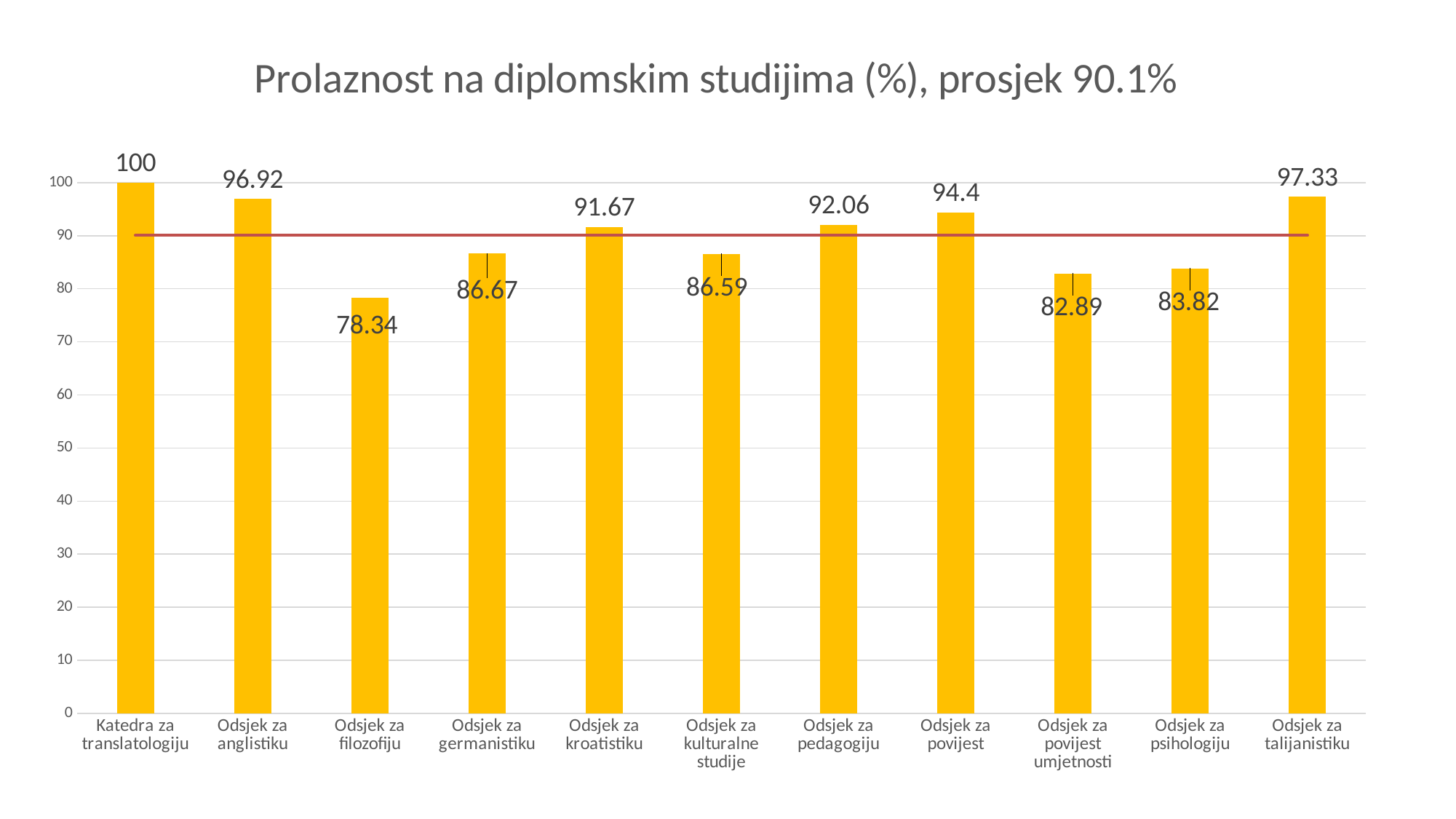
What is the title of the chart? Prolaznost na diplomskim studijima (%), prosjek 90.1% What is the value for Odsjek za filozofiju? 78.34 Which category has the lowest value? Odsjek za filozofiju What kind of chart is shown on the slide? bar chart Which is larger, the value for Odsjek za anglistiku or the value for Odsjek za kroatistiku? Odsjek za anglistiku What is the value for Odsjek za psihologiju? 83.82 How many categories are shown on the x axis? 11 What is the difference between the values for Odsjek za povijest and Odsjek za pedagogiju? 2.34 Is the value for Odsjek za povijest umjetnosti greater or less than 90? less What is the difference between the values for Katedra za translatologiju and Odsjek za filozofiju? 21.66 Which category has the highest value? Katedra za translatologiju What is the value for Odsjek za povijest? 94.4